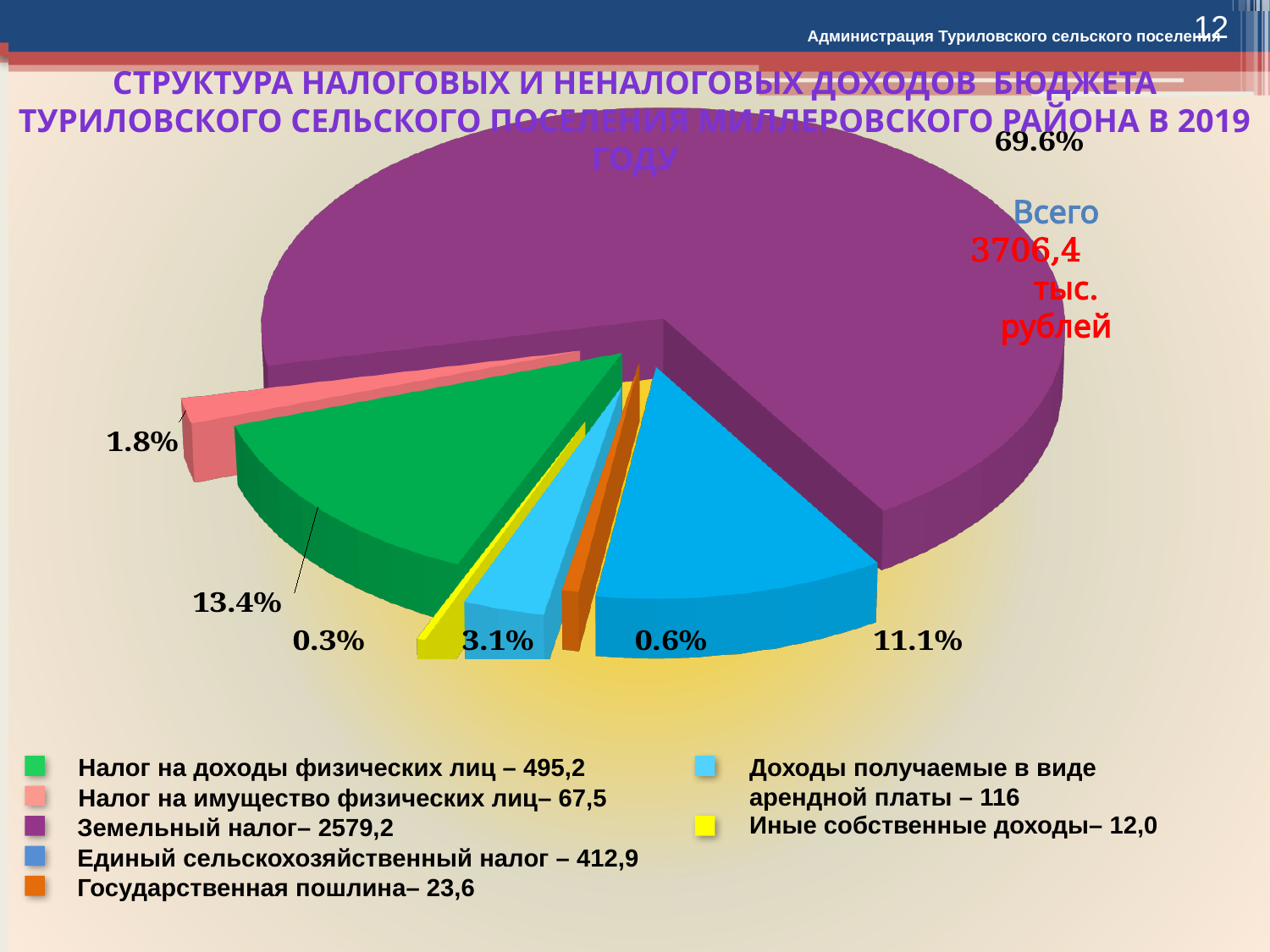
What type of chart is shown on the slide? Pie chart What percentage is shown for Налог на доходы физических лиц? 13.4% Which category has the smallest share of the pie? Иные собственные доходы What share of the pie does Земельный налог account for? 69.6% What percentage is shown for Единый сельскохозяйственный налог? 11.1% What is the difference in percentage points between Налог на доходы физических лиц and Единый сельскохозяйственный налог? 2.3 What percentage is shown for Доходы получаемые в виде арендной платы? 3.1% Which is larger: the share for Налог на имущество физических лиц or the share for Государственная пошлина? Налог на имущество физических лиц What value does the legend give for Государственная пошлина? 23,6 What total amount (Всего) is stated next to the chart? 3706,4 тыс. рублей How many categories does the pie chart show? 7 Which category has the largest share of the pie? Земельный налог